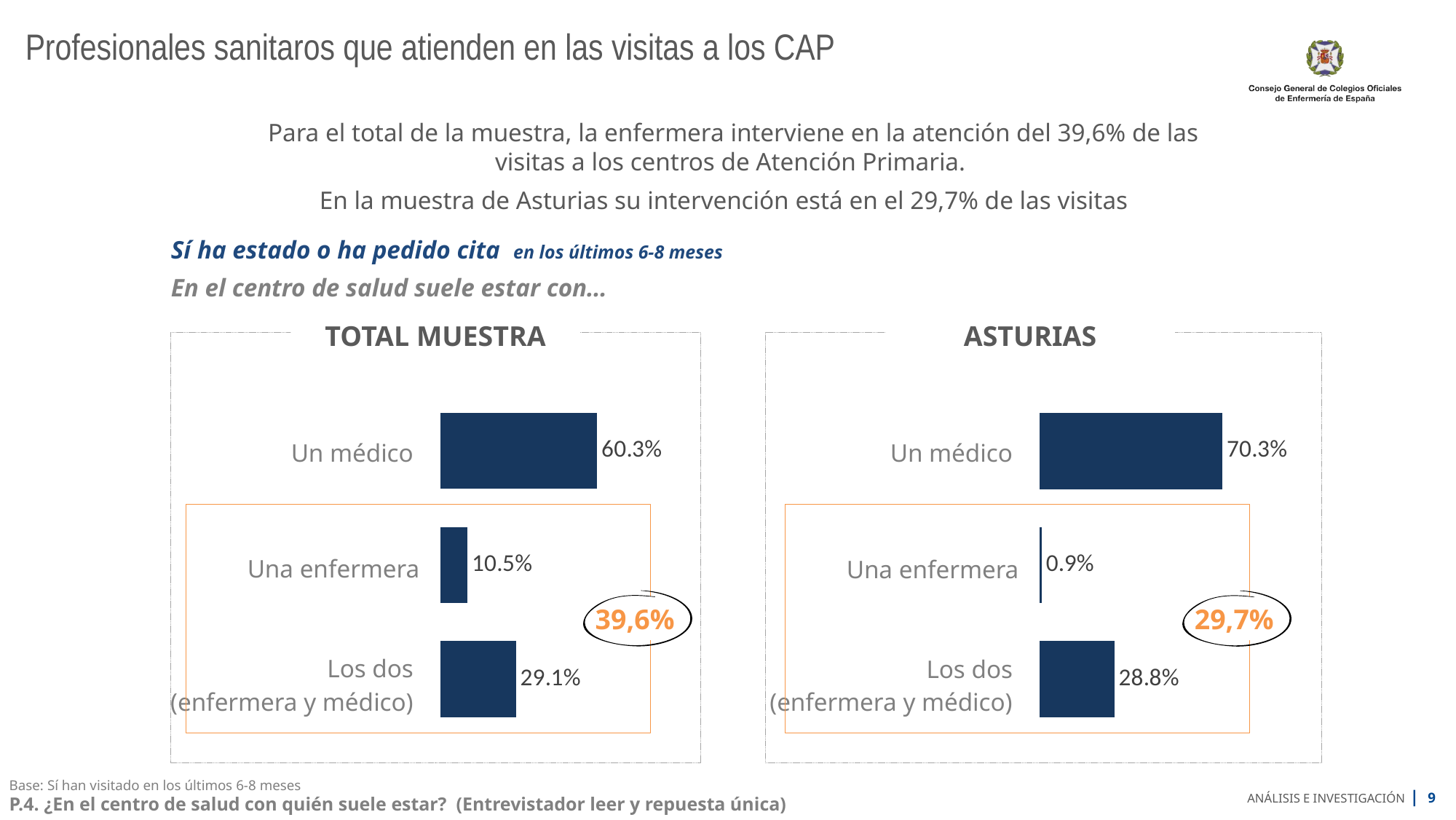
What kind of chart is the ASTURIAS chart? Bar chart In the TOTAL MUESTRA chart, which category has the lowest value? Una enfermera In the ASTURIAS chart, which category has the highest value? Un médico Which is larger: Una enfermera in the TOTAL MUESTRA chart or Una enfermera in the ASTURIAS chart? TOTAL MUESTRA In the ASTURIAS chart, what is the difference between Un médico and Una enfermera? 69.4% In the TOTAL MUESTRA chart, what is the value for Los dos (enfermera y médico)? 29.1% In the ASTURIAS chart, what is the value for Una enfermera? 0.9% What percentage is circled in orange on the ASTURIAS chart? 29,7% How many categories does the TOTAL MUESTRA chart show? 3 In the TOTAL MUESTRA chart, what is the difference between Un médico and Los dos (enfermera y médico)? 31.2% In the ASTURIAS chart, what is the value for Un médico? 70.3% In the TOTAL MUESTRA chart, what is the value for Un médico? 60.3%